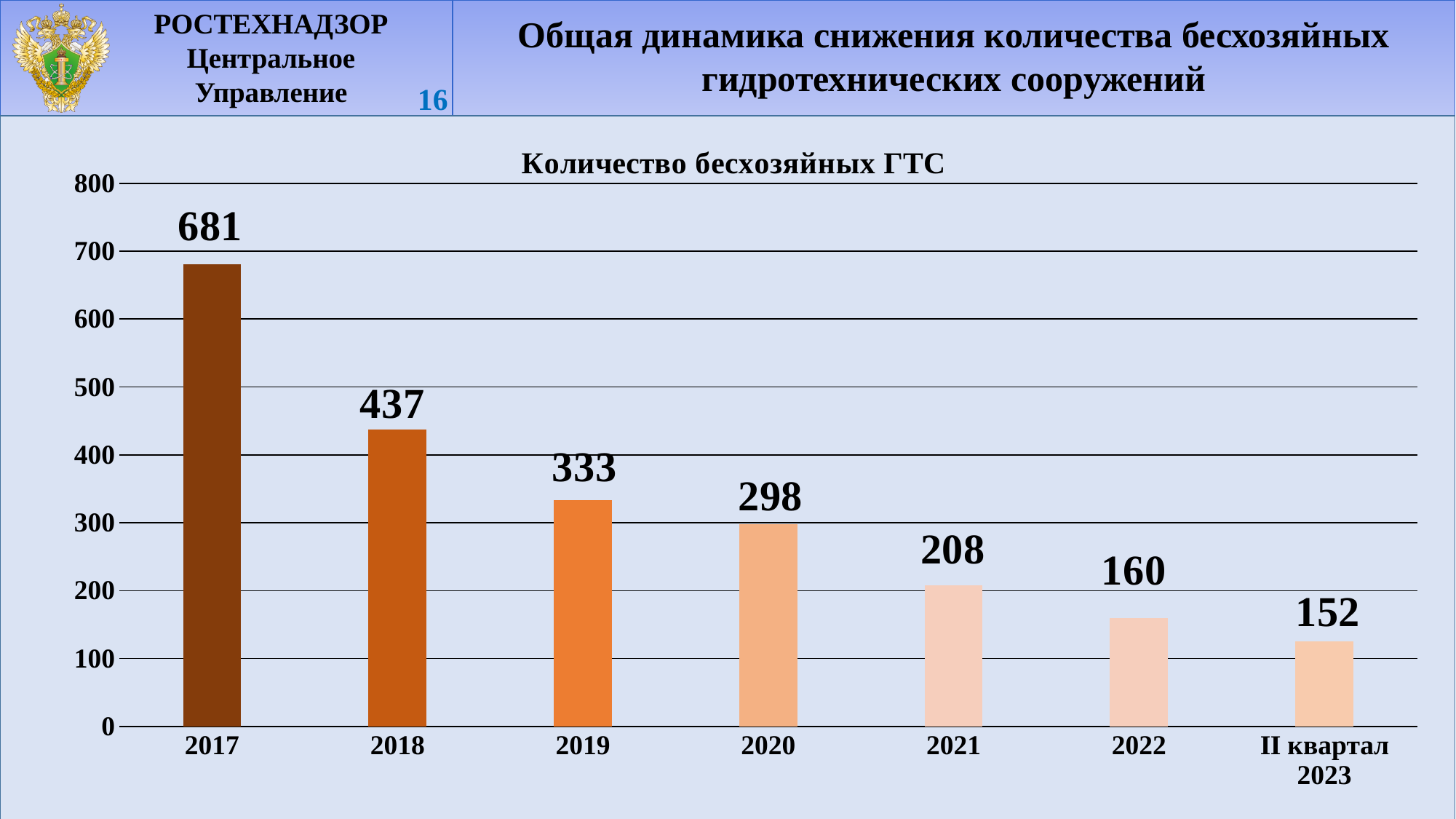
What kind of chart is shown? bar chart What is the difference between the values for 2017 and 2018? 244 What is the value for II квартал 2023? 152 Which category has the lowest value? II квартал 2023 Do the values rise or fall from 2017 to II квартал 2023? fall Which category has the highest value? 2017 What is the title of the chart? Количество бесхозяйных ГТС How many categories are shown on the x axis? 7 What is the value for 2017? 681 What is the value for 2020? 298 What is the difference between the values for 2021 and 2022? 48 Which is larger, the value for 2019 or the value for 2020? 2019